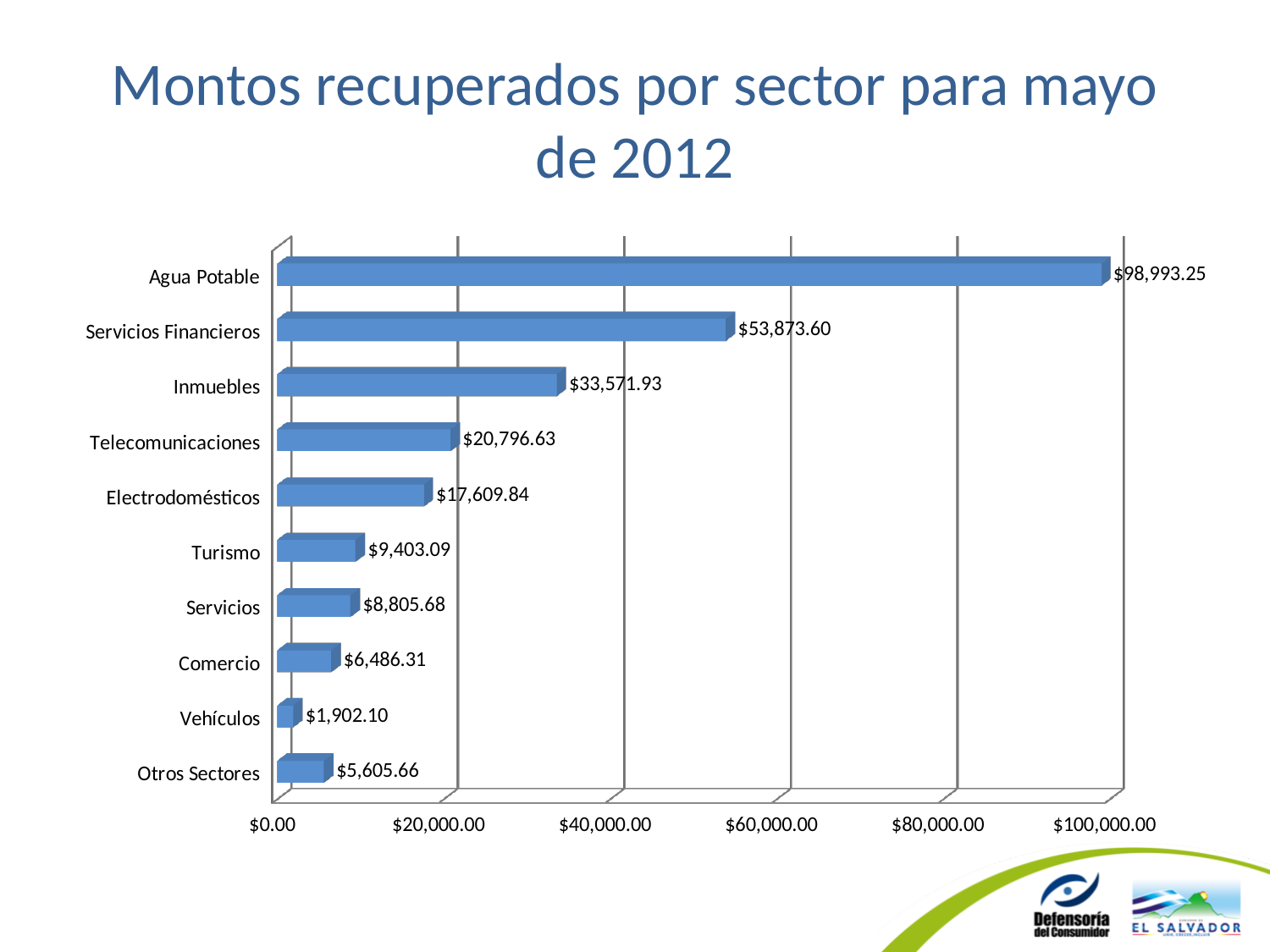
How many sectors are shown in the chart? 10 What is the title of the chart? Montos recuperados por sector para mayo de 2012 What is the value for Vehículos? $1,902.10 Which is larger, the value for Comercio or the value for Otros Sectores? Comercio What kind of chart is shown on the slide? Bar chart Which sector has the lowest recovered amount? Vehículos Which sector has the highest recovered amount? Agua Potable Is the value for Inmuebles greater or less than $20,000.00? greater What is the value for Agua Potable? $98,993.25 What is the value for Telecomunicaciones? $20,796.63 What is the difference between the values for Agua Potable and Servicios Financieros? $45,119.65 What is the difference between the values for Telecomunicaciones and Electrodomésticos? $3,186.79